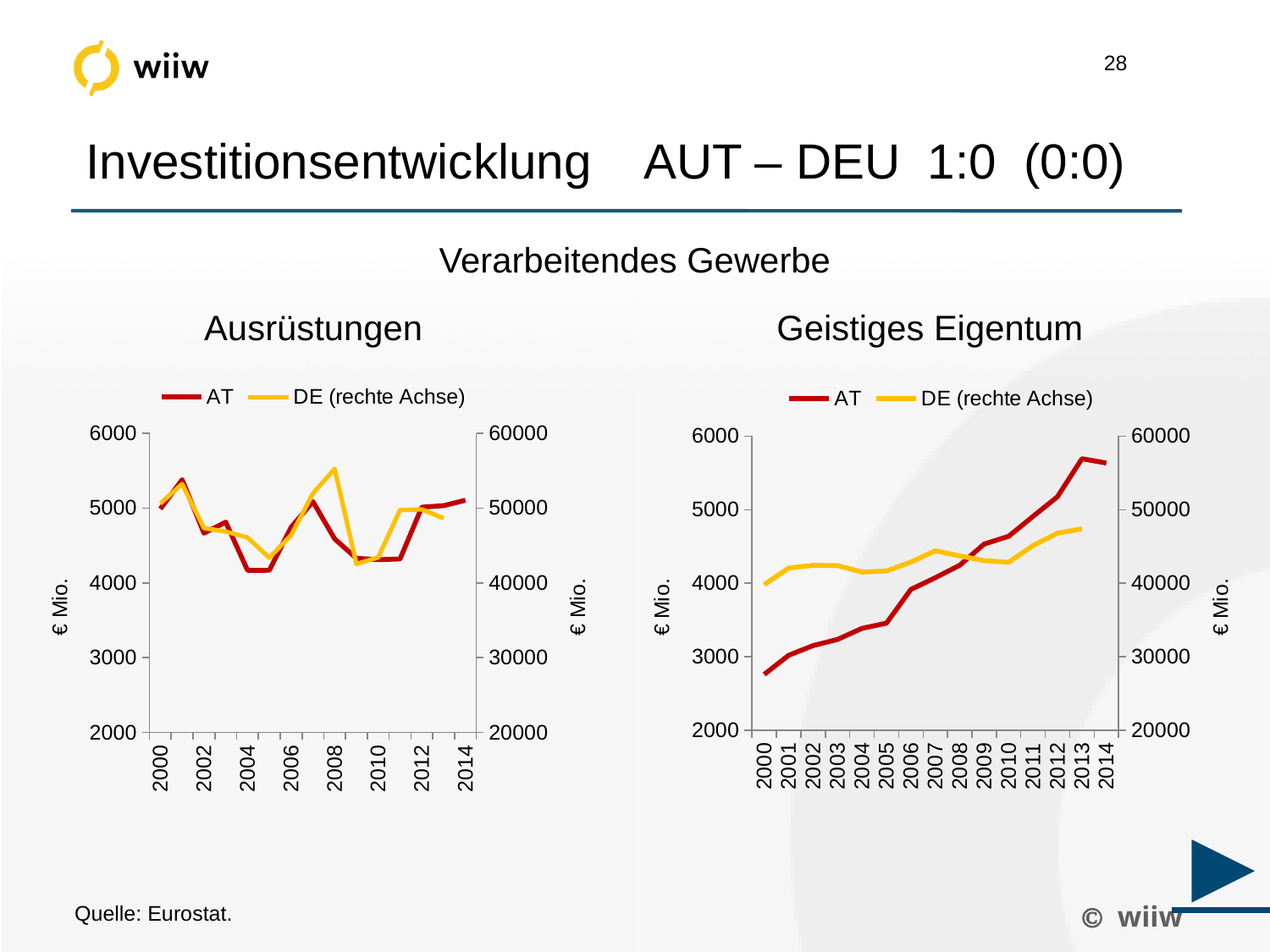
Which series in the 'Ausrüstungen' chart is plotted on the right axis according to the legend? DE How many years are labelled on the x axis of the 'Geistiges Eigentum' chart? 15 In the 'Geistiges Eigentum' chart, is the AT value for 2000 greater or less than 3000? less In the 'Geistiges Eigentum' chart, does the AT line rise or fall overall from 2000 to 2014? rise In the 'Ausrüstungen' chart, is the DE value for 2008 greater or less than 50000? greater In the 'Geistiges Eigentum' chart, is the DE value for 2007 greater or less than 40000? greater How many series does the legend of the 'Geistiges Eigentum' chart list? 2 In the 'Geistiges Eigentum' chart, which year has the highest AT value? 2013 What kind of chart is the 'Ausrüstungen' chart on the left? line chart What is the title of the chart on the right of the slide? Geistiges Eigentum